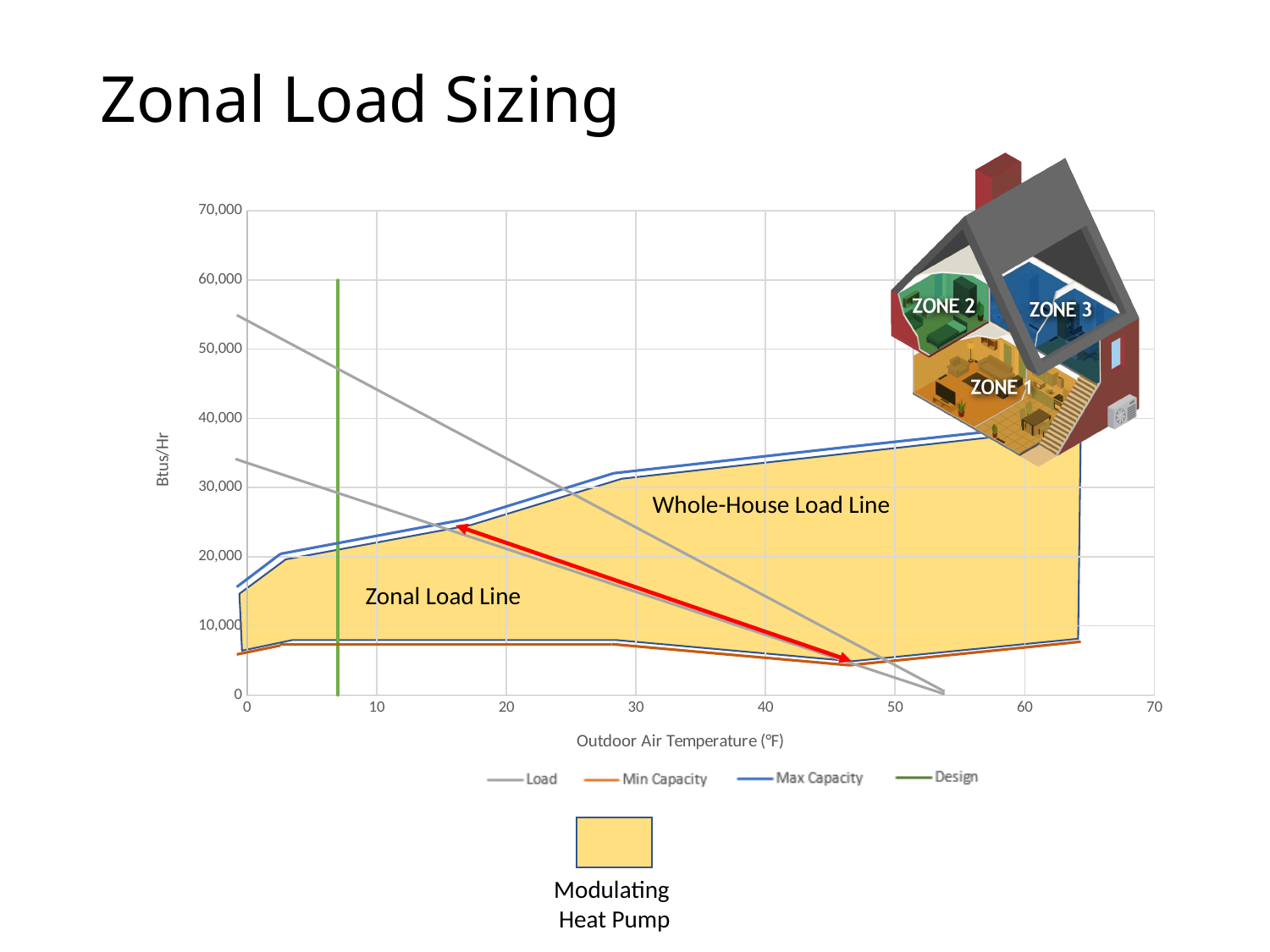
Is the Whole-House Load Line value at 0°F greater or less than 50,000? greater Does the Whole-House Load Line rise or fall as outdoor air temperature increases? fall At 60°F, which is larger: Max Capacity or Min Capacity? Max Capacity Is the Min Capacity value at 30°F greater or less than 10,000? less How many series does the chart legend list? 4 Does the Max Capacity line rise or fall as outdoor air temperature increases? rise What kind of chart is shown on the slide? line chart Is the Max Capacity value at 60°F greater or less than 30,000? greater What is the title of the x axis of the chart? Outdoor Air Temperature (°F) What is the title of the y axis of the chart? Btus/Hr